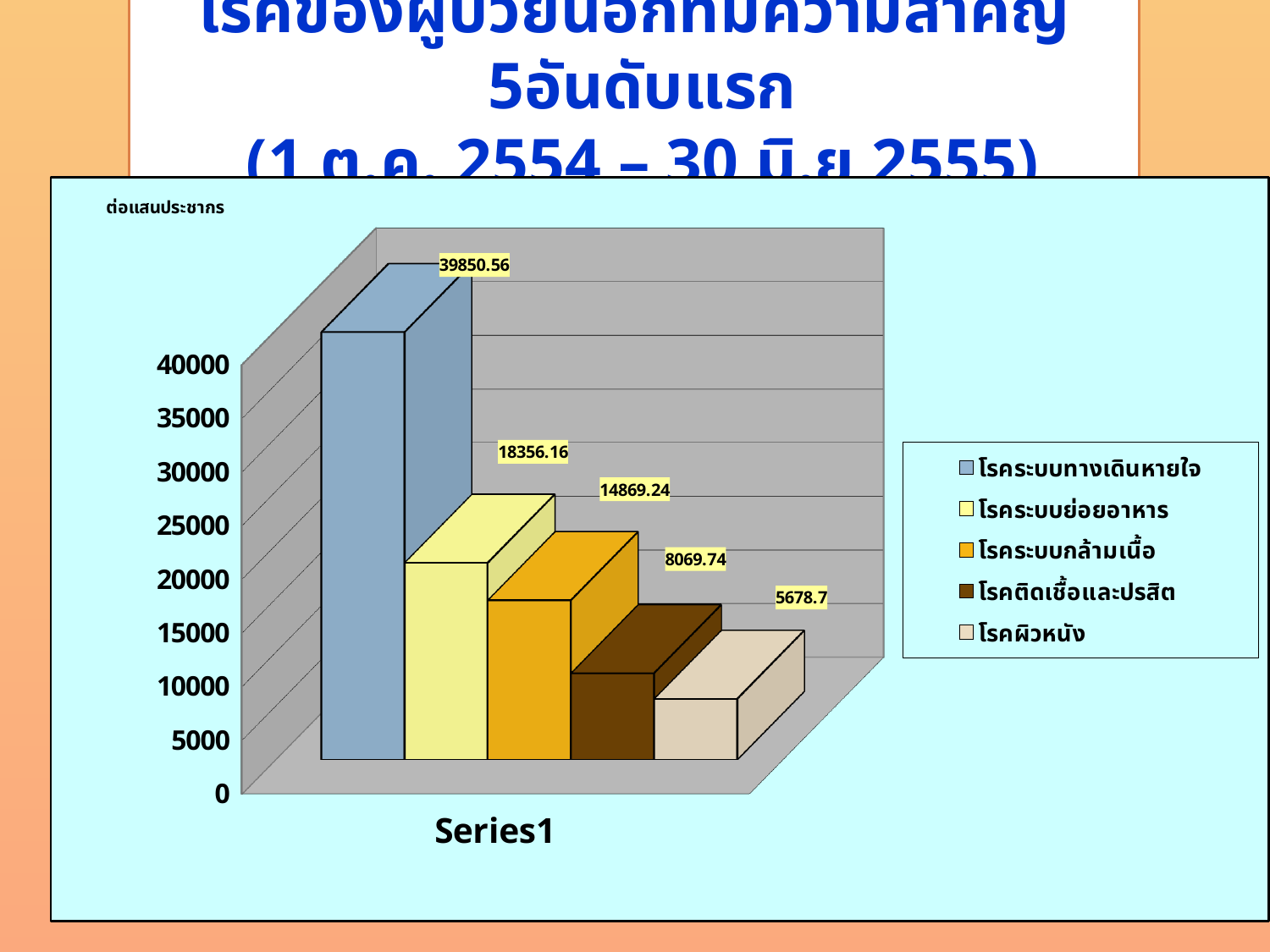
What is the difference between the values for โรคระบบทางเดินหายใจ and โรคระบบย่อยอาหาร? 21494.4 What is the difference between the values for โรคติดเชื้อและปรสิต and โรคผิวหนัง? 2391.04 Which is larger, the value for โรคระบบย่อยอาหาร or โรคระบบกล้ามเนื้อ? โรคระบบย่อยอาหาร What is the value for โรคระบบกล้ามเนื้อ? 14869.24 Which disease group has the lowest value? โรคผิวหนัง Which disease group has the highest value? โรคระบบทางเดินหายใจ How many entries does the legend list? 5 What is the value for โรคผิวหนัง? 5678.7 What is the value for โรคติดเชื้อและปรสิต? 8069.74 What is the value for โรคระบบย่อยอาหาร? 18356.16 What is the value for โรคระบบทางเดินหายใจ? 39850.56 What kind of chart is shown on the slide? Bar chart